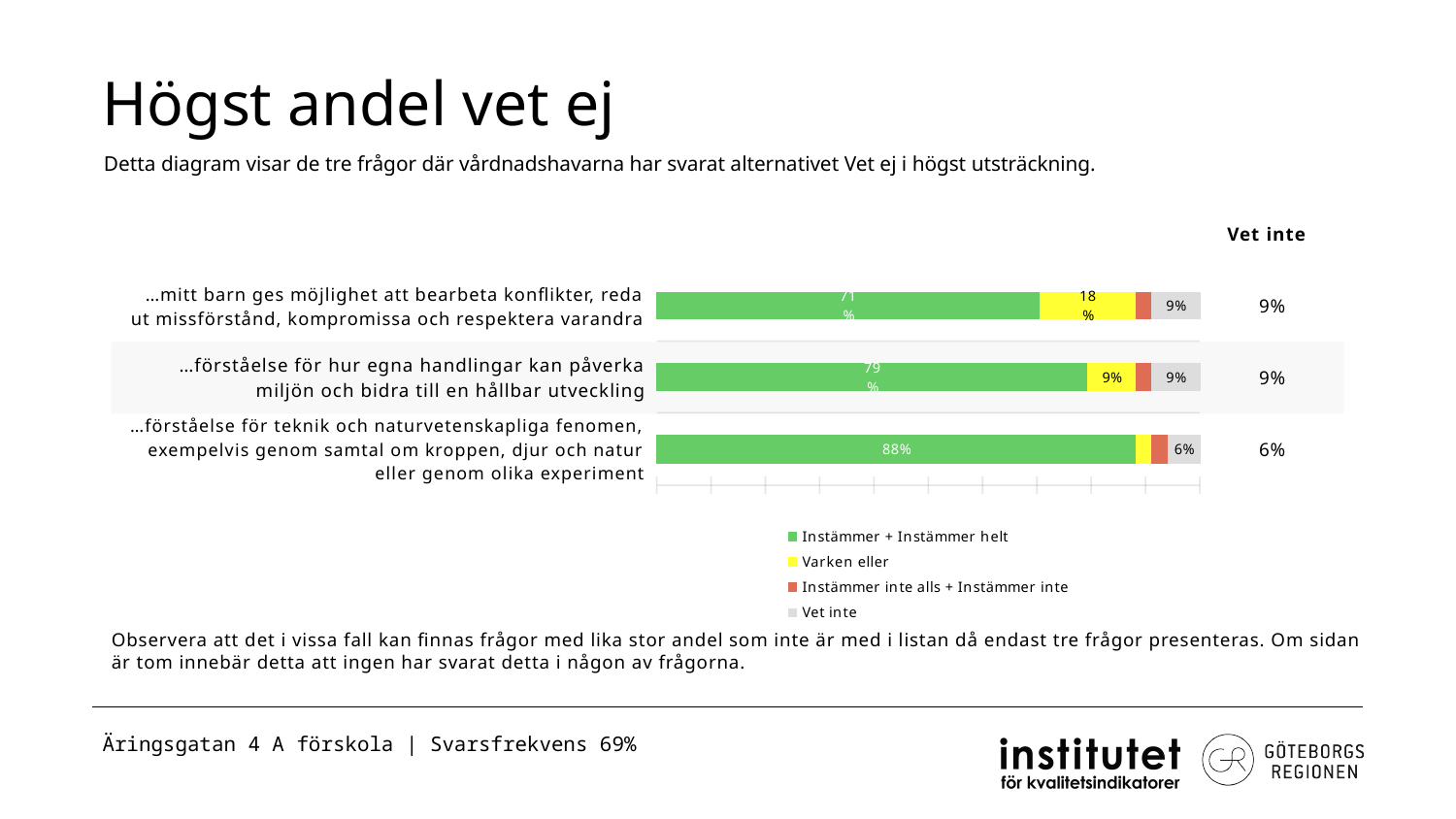
What kind of chart is shown on the slide? Stacked bar chart How many questions (categories) are shown in the chart? 3 How many series does the legend list? 4 What is the 'Instämmer + Instämmer helt' value for '…förståelse för teknik och naturvetenskapliga fenomen, exempelvis genom samtal om kroppen, djur och natur eller genom olika experiment'? 88% What is the 'Varken eller' value for '…förståelse för hur egna handlingar kan påverka miljön och bidra till en hållbar utveckling'? 9% What is the 'Vet inte' value for '…förståelse för teknik och naturvetenskapliga fenomen, exempelvis genom samtal om kroppen, djur och natur eller genom olika experiment'? 6% Which is larger: the 'Varken eller' share for '…mitt barn ges möjlighet att bearbeta konflikter…' or for '…förståelse för hur egna handlingar kan påverka miljön…'? …mitt barn ges möjlighet att bearbeta konflikter, reda ut missförstånd, kompromissa och respektera varandra What is the 'Instämmer + Instämmer helt' value for '…mitt barn ges möjlighet att bearbeta konflikter, reda ut missförstånd, kompromissa och respektera varandra'? 71% What is the difference in 'Instämmer + Instämmer helt' between '…förståelse för teknik och naturvetenskapliga fenomen…' (88%) and '…mitt barn ges möjlighet att bearbeta konflikter…' (71%)? 17 percentage points Which question has the lowest 'Vet inte' share? …förståelse för teknik och naturvetenskapliga fenomen, exempelvis genom samtal om kroppen, djur och natur eller genom olika experiment Which question has the highest 'Instämmer + Instämmer helt' share? …förståelse för teknik och naturvetenskapliga fenomen, exempelvis genom samtal om kroppen, djur och natur eller genom olika experiment What colour represents the 'Vet inte' series in the chart? Grey